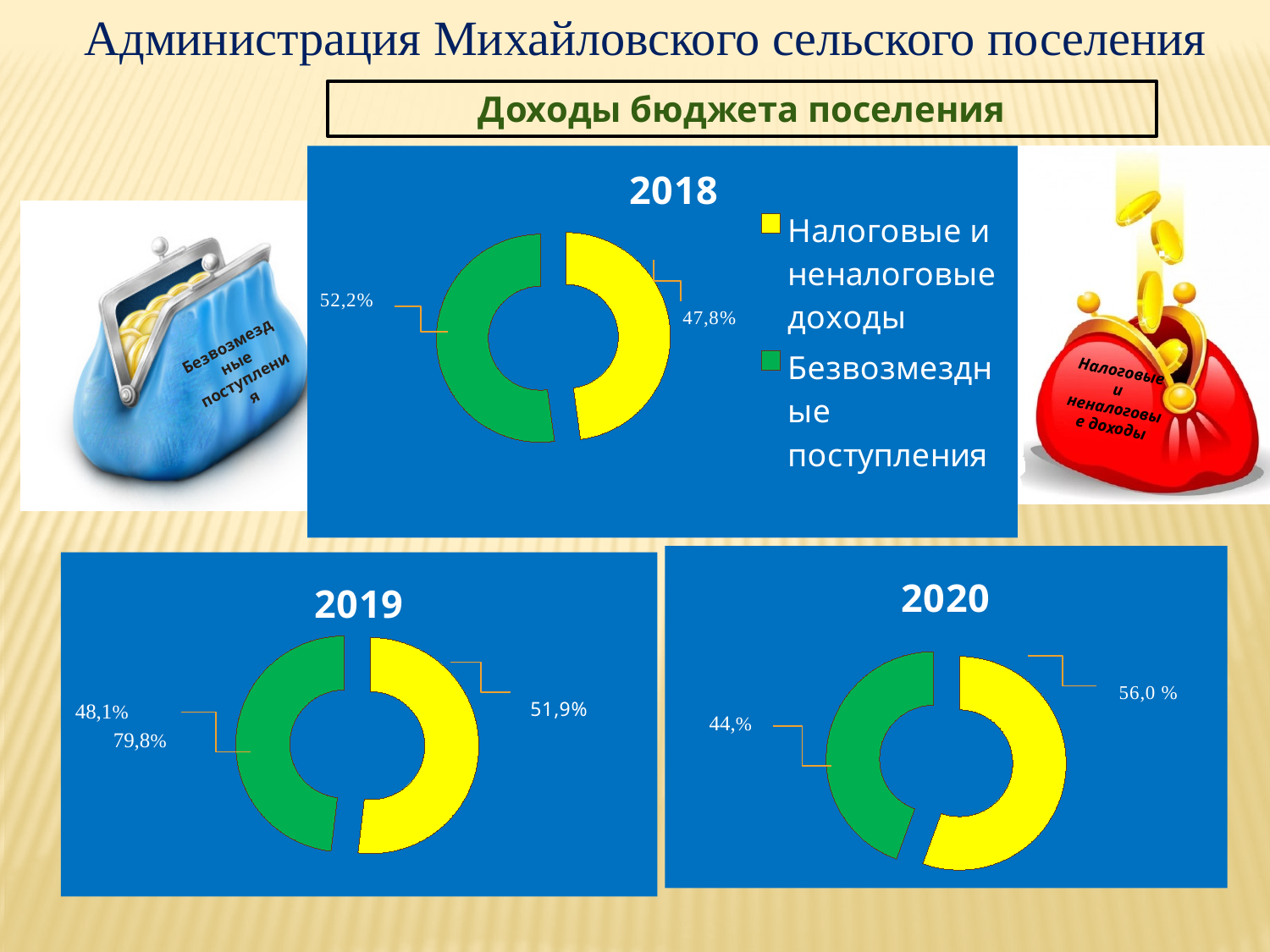
In the 2018 chart, what share is shown for Безвозмездные поступления? 52,2% In the 2018 chart, which category has the larger share? Безвозмездные поступления In the 2019 chart, what share is shown for the green segment (Безвозмездные поступления)? 48,1% In the 2019 chart, what share is shown for the yellow segment (Налоговые и неналоговые доходы)? 51,9% In the 2018 chart, what share is shown for Налоговые и неналоговые доходы? 47,8% What type of chart is used for the 2019 data? doughnut chart In the 2018 chart legend, which colour represents Налоговые и неналоговые доходы? yellow How many doughnut charts are shown on the slide? 3 In the 2020 chart, what share is shown for the yellow segment (Налоговые и неналоговые доходы)? 56,0 % In the 2020 chart, which segment is larger, the yellow or the green one? yellow How many series does the legend of the 2018 chart list? 2 In the 2018 chart, what is the difference between the share of Безвозмездные поступления and the share of Налоговые и неналоговые доходы? 4,4%